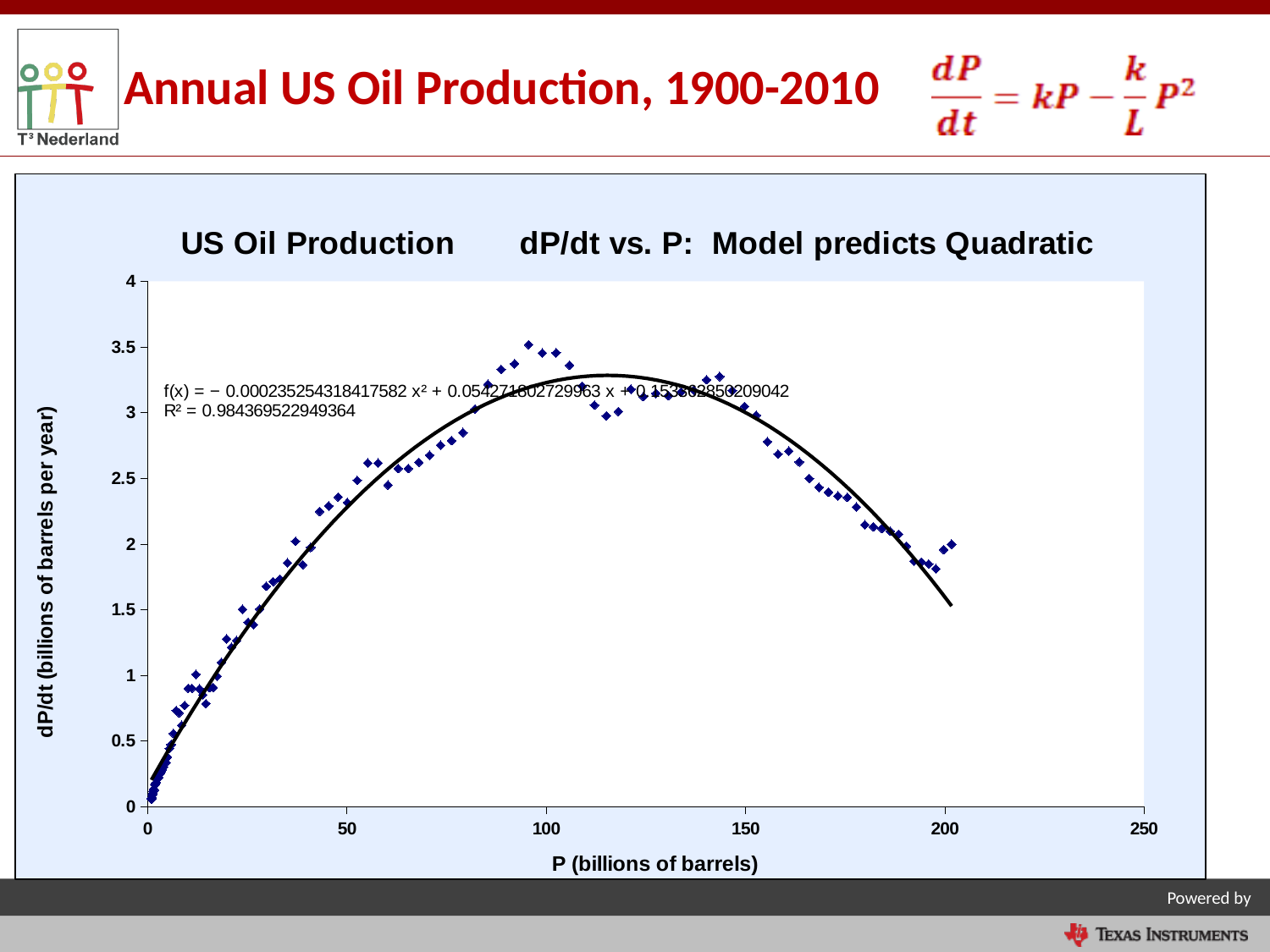
Do the dP/dt values rise or fall as P increases from 150 to 200? fall Which has the larger dP/dt value: the point at P = 100 or the point at P = 200? P = 100 Is the value of dP/dt at P = 100 greater or less than 3? greater What kind of chart is shown on the slide? Scatter chart What is the coefficient of x² in the fitted equation f(x) printed on the chart? −0.000235254318417582 Is the value of dP/dt at P = 200 greater or less than 2.5? less Do the dP/dt values rise or fall as P increases from 0 to 100? rise What is the title of the chart? US Oil Production dP/dt vs. P: Model predicts Quadratic What is the label of the x axis of the chart? P (billions of barrels) What R² value is printed on the chart for the fitted curve? 0.984369522949364 Is the value of dP/dt at P = 50 greater or less than 2? greater